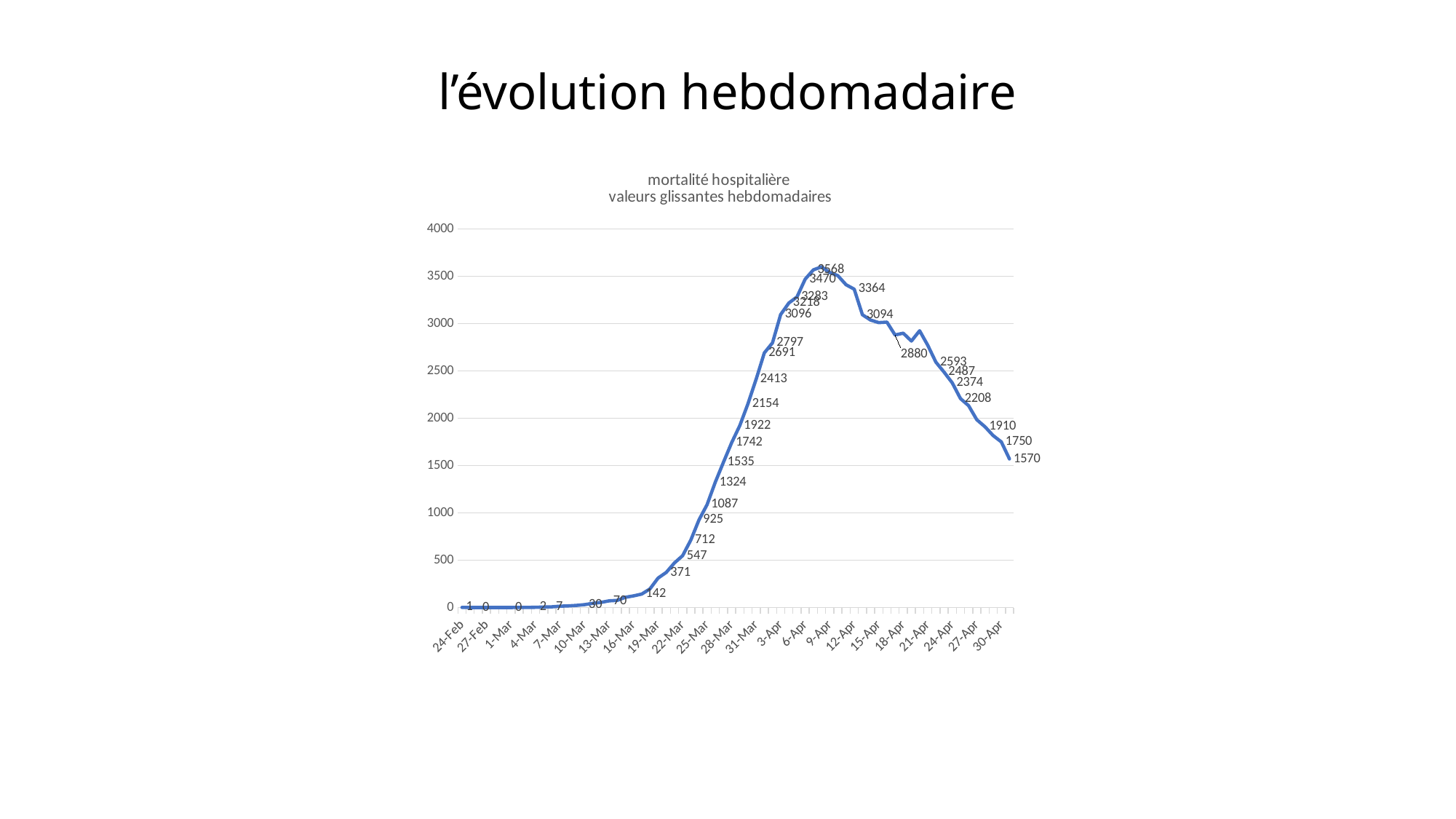
Does the line rise or fall between 12-Apr and 30-Apr? fall Is the value at 1-Mar greater or less than 500? less What is the value labelled at the last point, 30-Apr? 1570 Is the value at 30-Apr greater or less than 1500? greater What is the difference between the peak value (3568) and the final value at 30-Apr (1570)? 1998 Is the value at 9-Apr greater or less than 3000? greater What is the highest value labelled on the line? 3568 What is the title of the chart? mortalité hospitalière valeurs glissantes hebdomadaires How many lines (series) are plotted on the chart? 1 What is the maximum value shown on the vertical axis? 4000 What kind of chart is shown on the slide? line chart Does the line rise or fall between 24-Feb and 9-Apr? rise